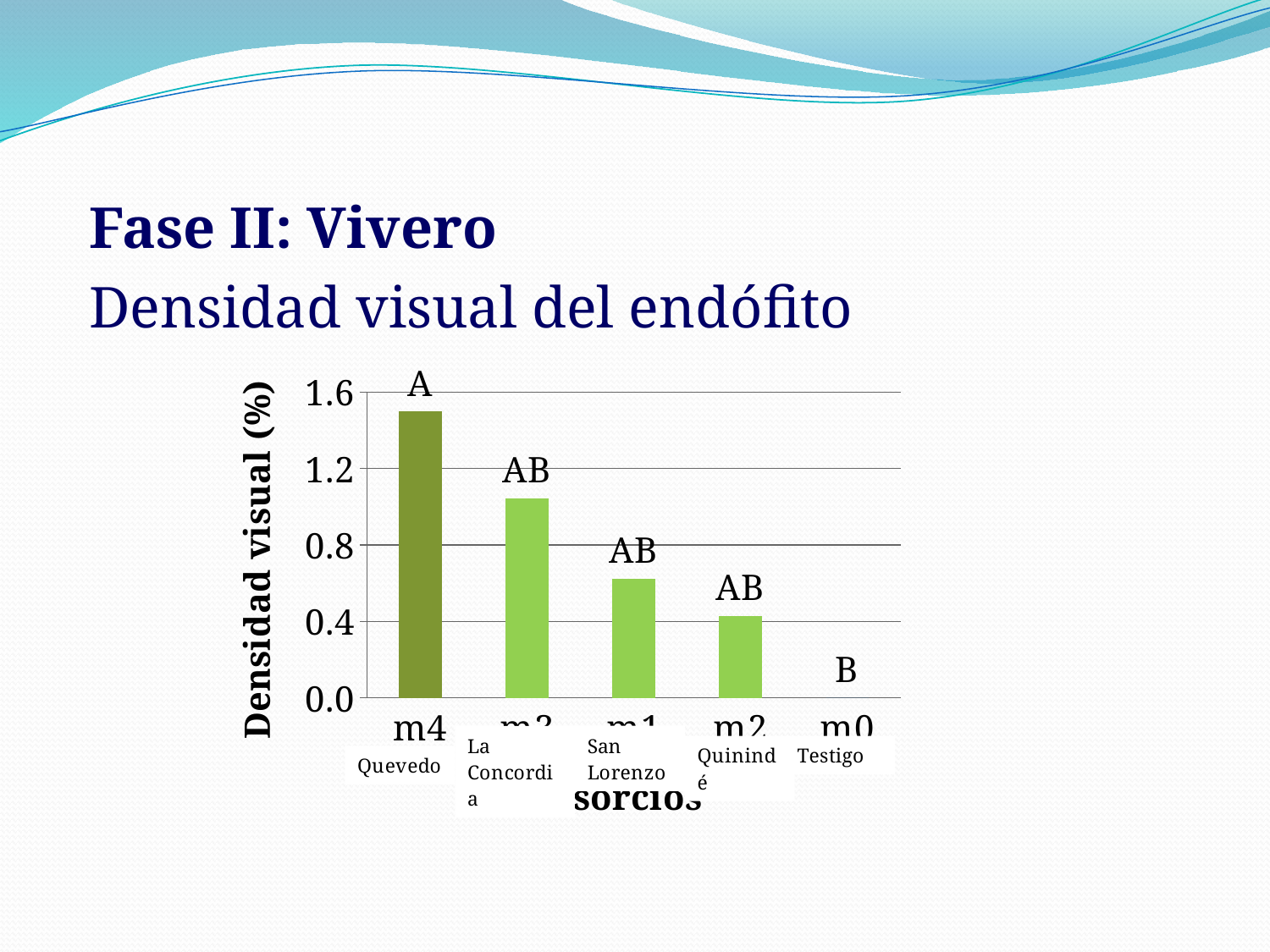
Is the value for Quevedo (m4) greater or less than 1.2? greater Is the value for San Lorenzo greater or less than 0.8? less Which category has the lowest visual density in the chart? Testigo (m0) Is the value for La Concordia greater or less than 0.8? greater Which category has the highest visual density in the chart? Quevedo (m4) Which is larger, the value for San Lorenzo or the value for Quinindé? San Lorenzo How many categories are plotted on the x axis of the chart? 5 Which is larger, the value for Quevedo or the value for La Concordia? Quevedo Do the bar values rise or fall moving from left to right along the x axis? fall What is the title of the y axis of the chart? Densidad visual (%) What kind of chart is shown on the slide? bar chart